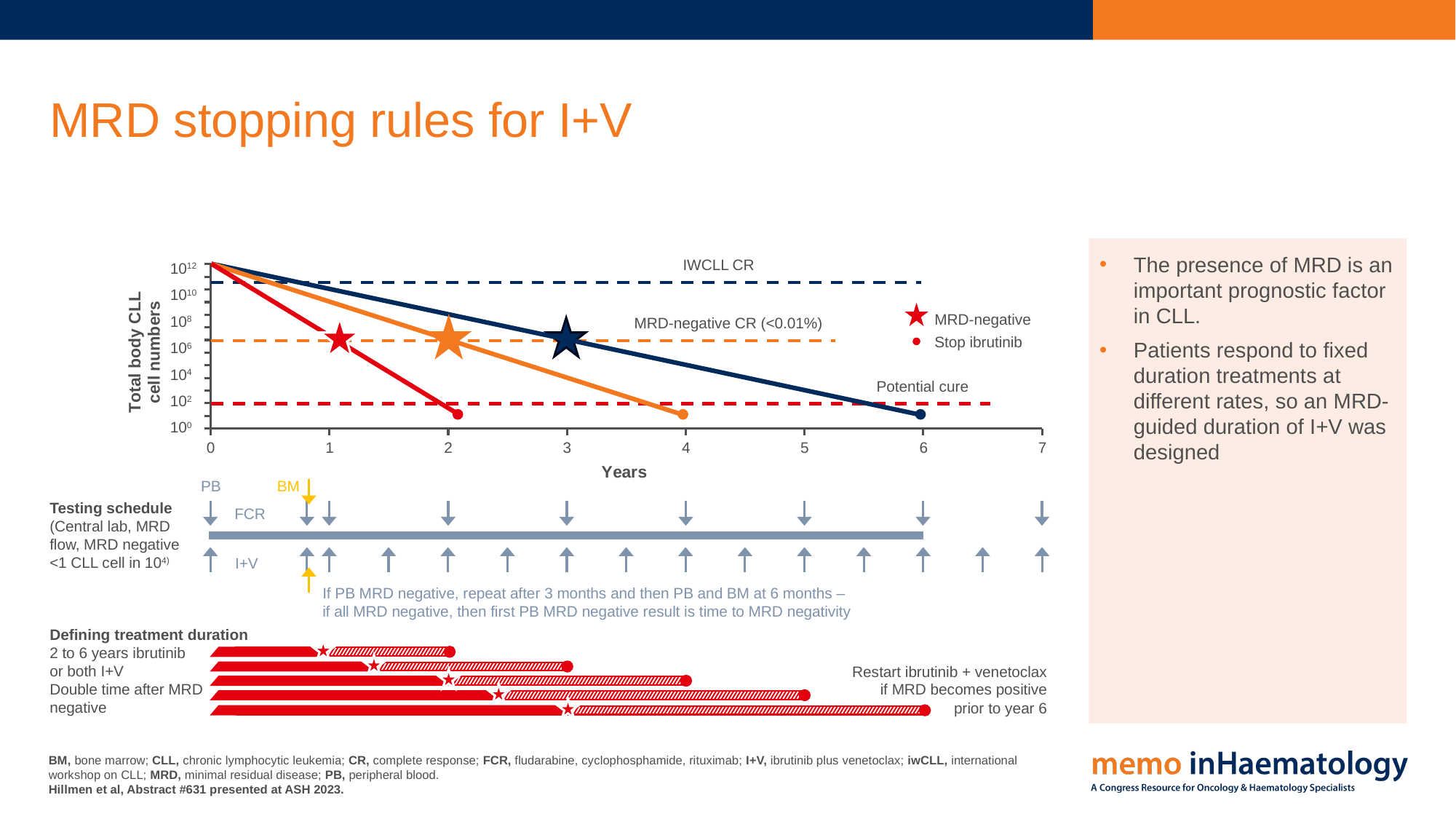
At what year does the dark blue line reach its 'Stop ibrutinib' point? 6 Which line reaches its 'Stop ibrutinib' point latest? Dark blue line Which line reaches its 'Stop ibrutinib' point earliest? Red line How many solid lines (patient trajectories) are plotted on the chart? 3 What is the label of the x axis? Years At what year does the orange line reach its 'Stop ibrutinib' point? 4 Which reaches 'Stop ibrutinib' later, the orange line or the red line? Orange line How many entries does the chart legend list? 2 At what year does the red line reach its 'Stop ibrutinib' point? 2 Do the plotted lines rise or fall as years increase? Fall What is the label of the y axis? Total body CLL cell numbers What kind of chart is shown on the slide? Line chart